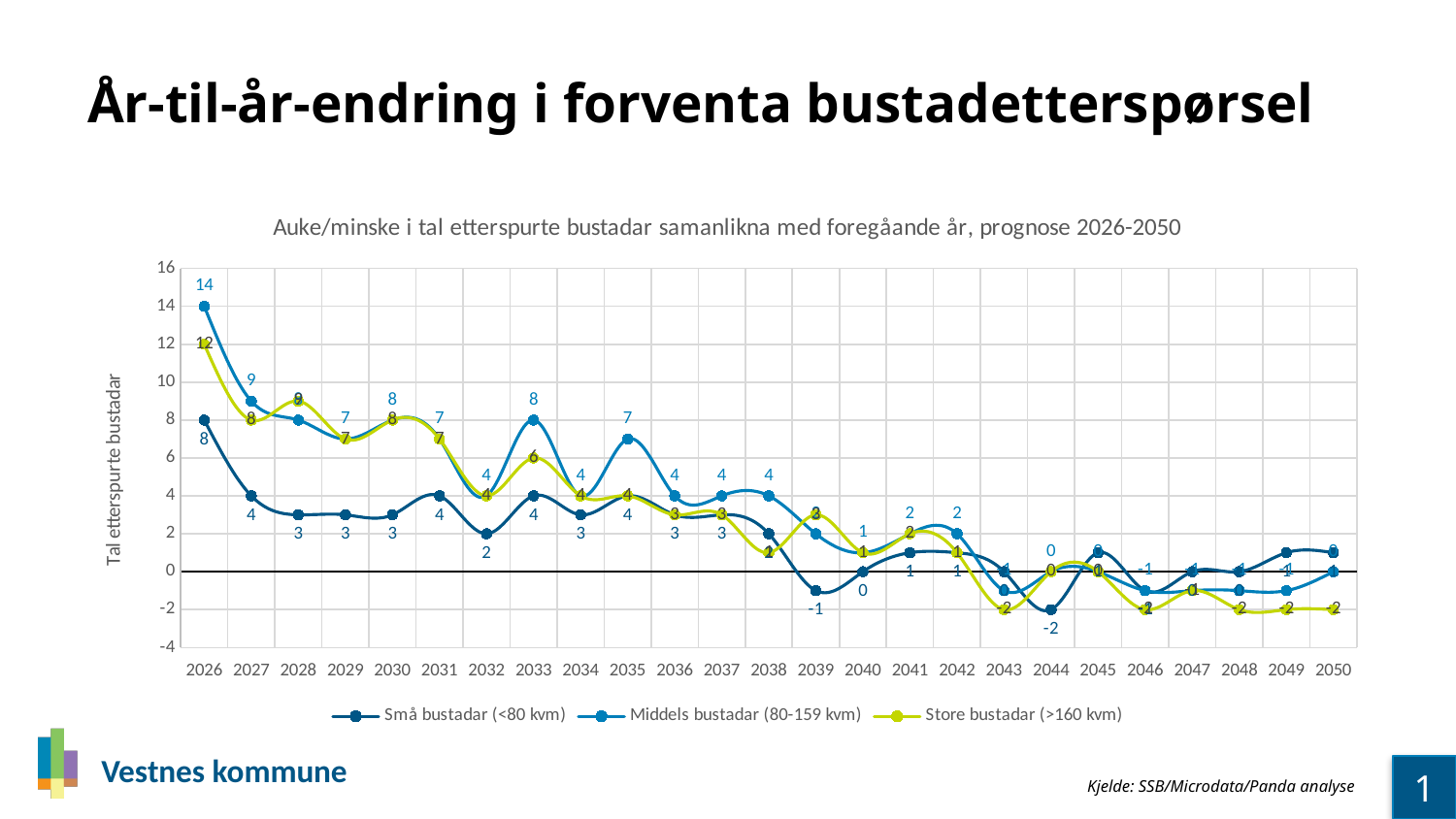
What is the difference between Middels bustadar (80-159 kvm) and Små bustadar (<80 kvm) in 2026? 6 In which year does Middels bustadar (80-159 kvm) reach its highest value? 2026 How many years are plotted along the x axis? 25 How many series does the legend list? 3 Do the values for Middels bustadar (80-159 kvm) generally rise or fall from 2026 to 2050? fall What is the value for Middels bustadar (80-159 kvm) in 2026? 14 In 2035, which is larger: Middels bustadar (80-159 kvm) or Små bustadar (<80 kvm)? Middels bustadar (80-159 kvm) What is the value for Små bustadar (<80 kvm) in 2044? -2 Is the value for Store bustadar (>160 kvm) in 2026 greater or less than 10? greater What kind of chart is shown on the slide? line chart What is the value for Små bustadar (<80 kvm) in 2026? 8 What is the value for Middels bustadar (80-159 kvm) in 2033? 8